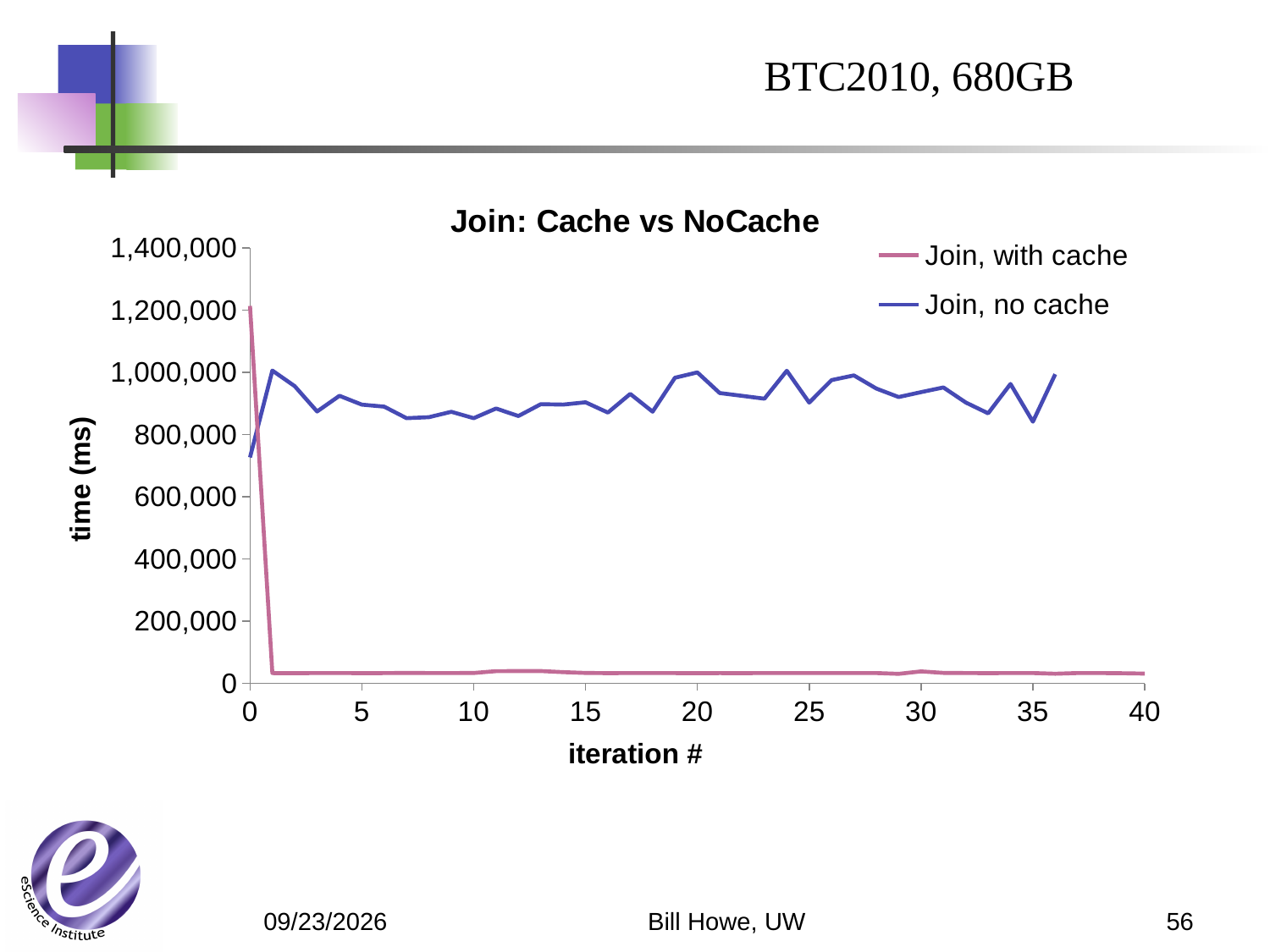
At iteration 0, which series has the higher value, 'Join, with cache' or 'Join, no cache'? Join, with cache Does the 'Join, with cache' series rise or fall from iteration 0 to iteration 1? fall How many series does the legend list? 2 What is the title of the chart? Join: Cache vs NoCache Is the value for 'Join, no cache' at iteration 0 greater or less than 800,000? less Is the value for 'Join, with cache' at iteration 0 greater or less than 1,000,000? greater Is the value for 'Join, no cache' at iteration 20 greater or less than 800,000? greater At iteration 20, which series has the higher value, 'Join, with cache' or 'Join, no cache'? Join, no cache What kind of chart is shown on the slide? line chart What is the label of the y axis? time (ms) Which series stays higher across most of the iterations? Join, no cache